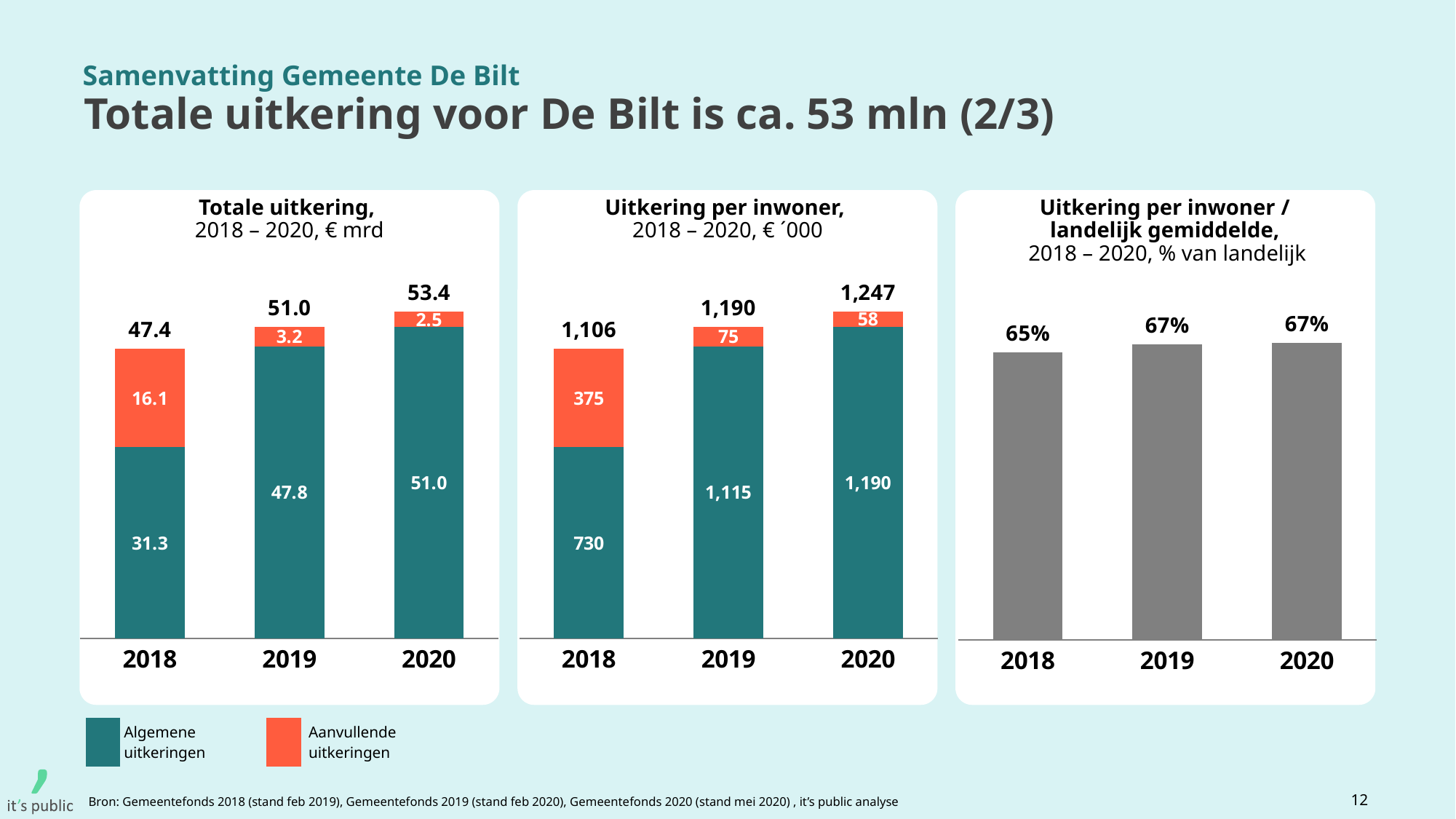
In the 'Uitkering per inwoner' chart, what is the total for 2018? 1,106 In the 'Totale uitkering' chart, which year has the lowest total? 2018 In the 'Uitkering per inwoner' chart, what is the value of Algemene uitkeringen for 2020? 1,190 In the 'Uitkering per inwoner' chart, is the Aanvullende uitkeringen value larger in 2018 or in 2019? 2018 In the 'Totale uitkering' chart, what is the value of Aanvullende uitkeringen for 2019? 3.2 In the 'Uitkering per inwoner / landelijk gemiddelde' chart, how many years are shown? 3 In the 'Uitkering per inwoner' chart, what is the difference between the totals for 2020 and 2019? 57 In the 'Totale uitkering' chart, what is the value of Algemene uitkeringen for 2018? 31.3 What kind of chart is the 'Totale uitkering' chart? Stacked bar chart In the 'Totale uitkering' chart, what is the total of the stacked bar for 2020? 53.4 In the 'Uitkering per inwoner / landelijk gemiddelde' chart, what is the value for 2018? 65% How many series does the legend at the bottom of the slide list? 2